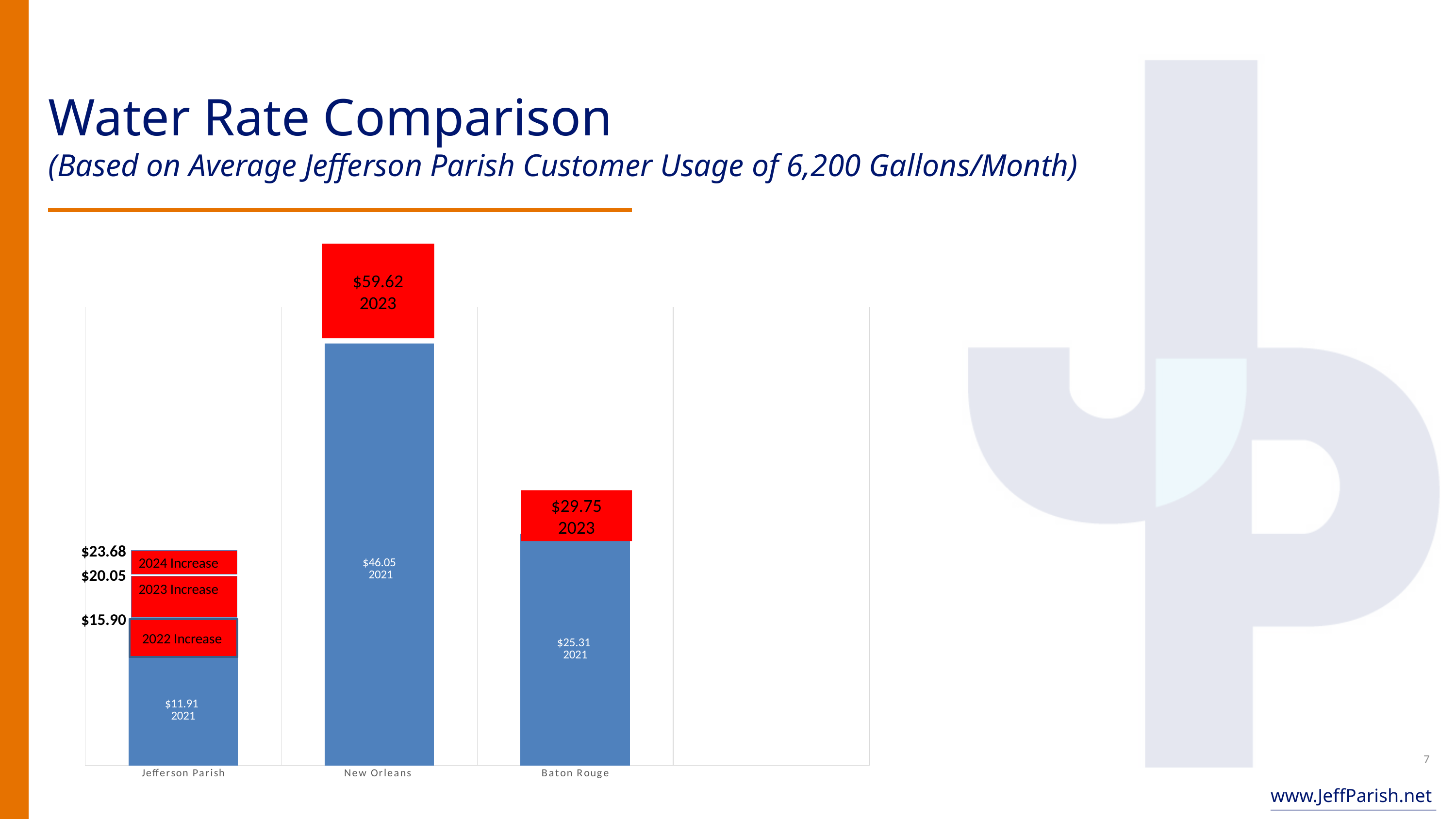
Which location has the highest total water rate in the chart? New Orleans What kind of chart is shown on the slide? bar chart What is the 2021 water rate for Jefferson Parish? $11.91 What is the difference between the New Orleans 2023 rate and its 2021 rate? $13.57 What is the 2021 water rate for New Orleans? $46.05 What is the Jefferson Parish water rate after the 2024 increase? $23.68 What is the title of the chart on the slide? Water Rate Comparison Which is larger: the Baton Rouge 2021 rate or the Jefferson Parish rate after the 2024 increase? Baton Rouge 2021 rate What is the Jefferson Parish water rate after the 2022 increase? $15.90 How many cities or parishes are compared in the chart? 3 Which location has the lowest total water rate in the chart? Jefferson Parish What is the 2023 water rate for Baton Rouge? $29.75